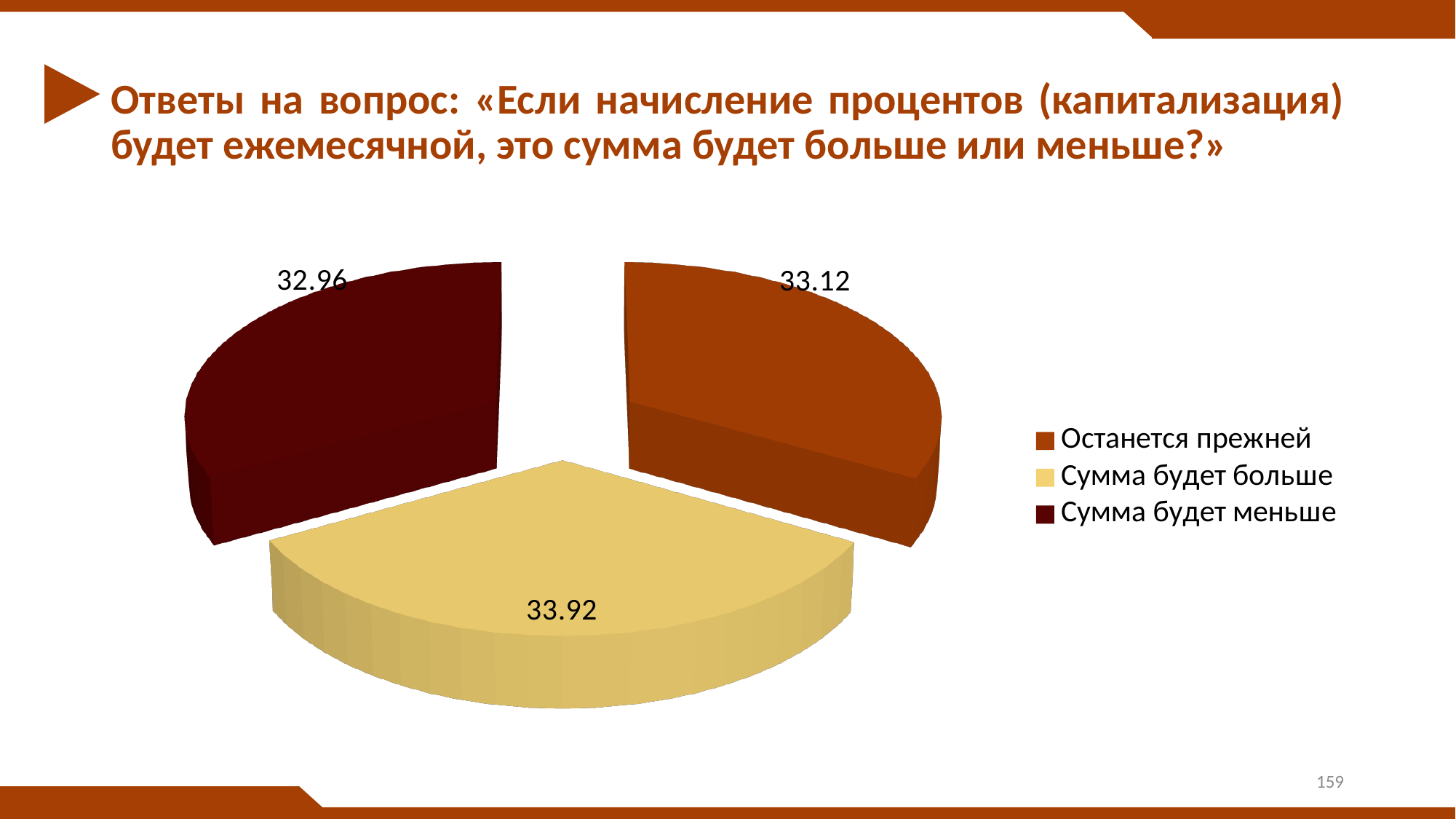
What is the difference between the values for "Сумма будет больше" and "Сумма будет меньше"? 0.96 Which answer option has the largest slice of the pie? Сумма будет больше What kind of chart is shown on the slide? pie chart What is the value for "Сумма будет меньше"? 32.96 What colour is the slice for "Сумма будет меньше"? dark red How many entries does the legend list? 3 What is the value for "Сумма будет больше"? 33.92 Which answer option has the smallest slice of the pie? Сумма будет меньше What is the difference between the values for "Останется прежней" and "Сумма будет меньше"? 0.16 What is the value for "Останется прежней"? 33.12 How many slices does the pie chart have? 3 Which is larger, the value for "Сумма будет больше" or the value for "Останется прежней"? Сумма будет больше